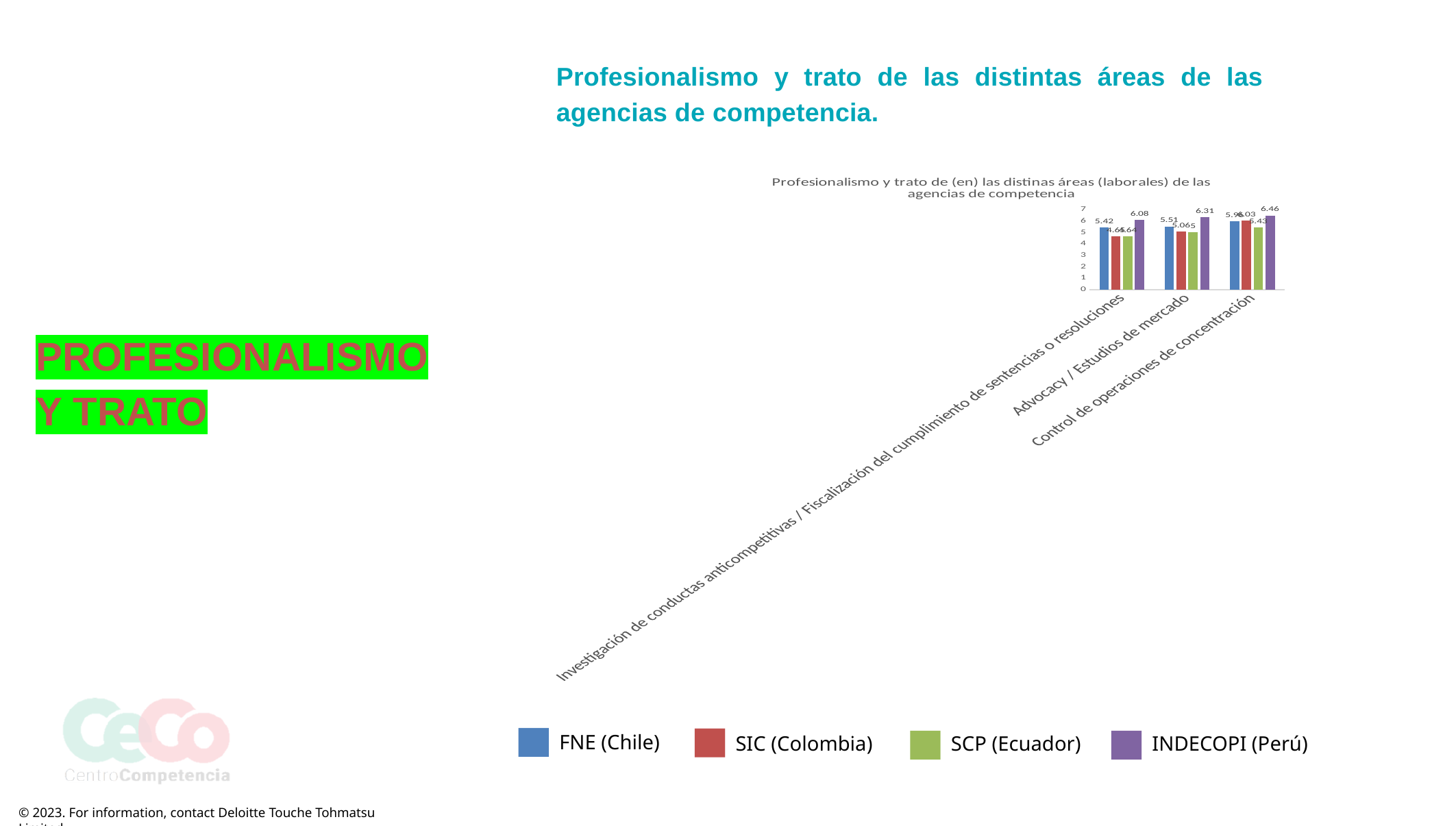
What is the value for INDECOPI (Perú) in the category 'Control de operaciones de concentración'? 6.46 What is the difference between the INDECOPI (Perú) and FNE (Chile) values in the category 'Investigación de conductas anticompetitivas / Fiscalización del cumplimiento de sentencias o resoluciones'? 0.66 How many categories are shown on the x axis of the chart? 3 How many series does the chart legend list? 4 Which colour represents INDECOPI (Perú) in the chart legend? Purple What is the value for INDECOPI (Perú) in the category 'Investigación de conductas anticompetitivas / Fiscalización del cumplimiento de sentencias o resoluciones'? 6.08 What is the value for FNE (Chile) in the category 'Investigación de conductas anticompetitivas / Fiscalización del cumplimiento de sentencias o resoluciones'? 5.42 What is the value for SCP (Ecuador) in the category 'Control de operaciones de concentración'? 5.43 What is the value for INDECOPI (Perú) in the category 'Advocacy / Estudios de mercado'? 6.31 What kind of chart is shown on the slide? Bar chart What is the value for FNE (Chile) in the category 'Advocacy / Estudios de mercado'? 5.51 In which category does INDECOPI (Perú) have its highest value? Control de operaciones de concentración